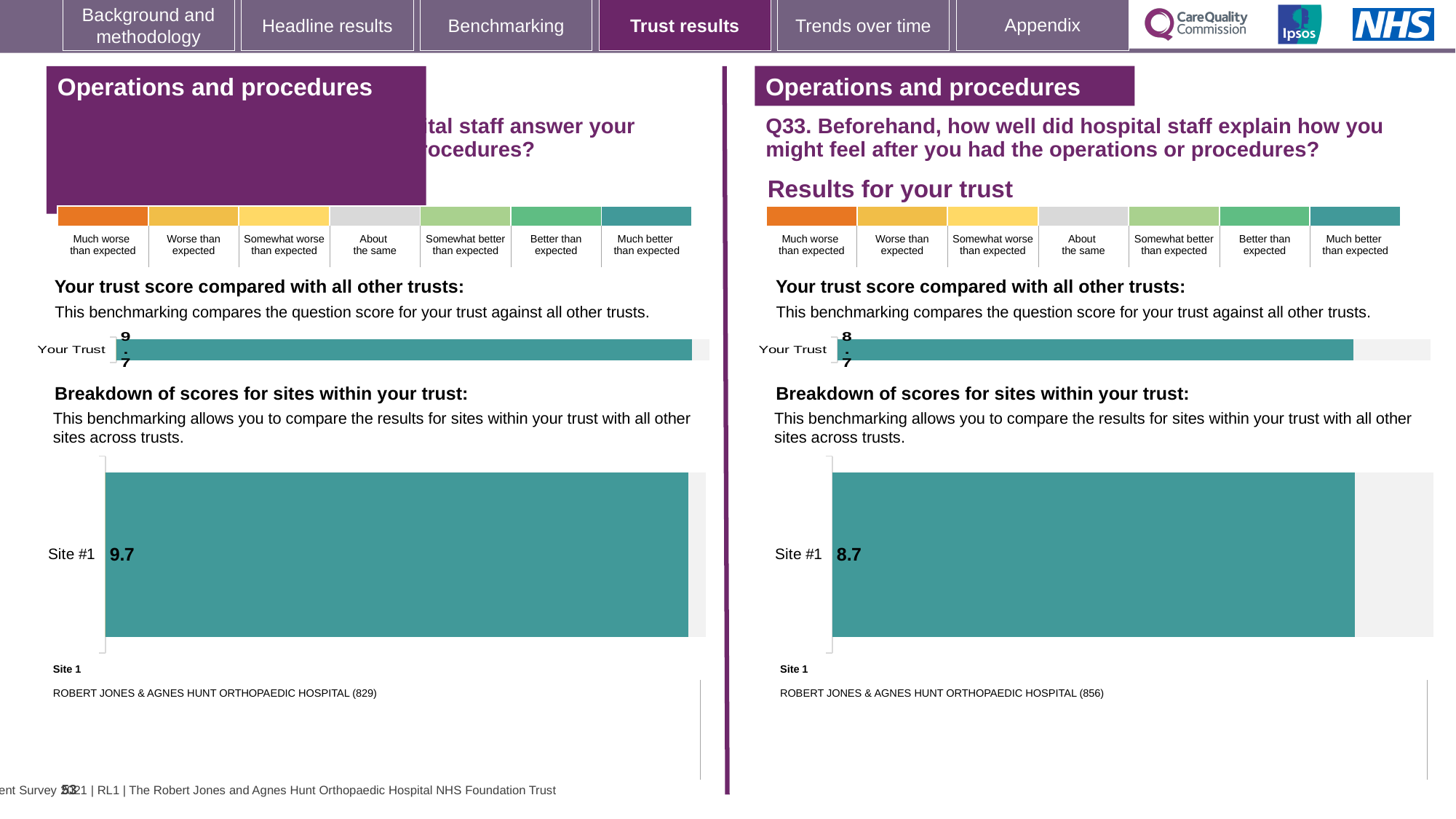
On the left-hand panel, what score is shown for Site #1 in the 'Breakdown of scores for sites within your trust' chart? 9.7 Which is larger: the Site #1 score on the left-hand panel or the Site #1 score on the right-hand panel (Q33)? Left-hand panel (9.7) How many sites are shown in the 'Breakdown of scores for sites within your trust' chart on the right-hand panel (Q33)? 1 How many categories are shown in the colour scale legend above the charts on the right-hand panel (from 'Much worse than expected' to 'Much better than expected')? 7 Is the Your Trust score on the right-hand panel (Q33) the same as the Site #1 score on that panel? Yes, both are 8.7 What type of chart is used to show the Site #1 score on the right-hand panel (Q33)? Bar chart Which site name is listed as Site 1 on the right-hand panel (Q33)? ROBERT JONES & AGNES HUNT ORTHOPAEDIC HOSPITAL (856) On the right-hand panel (Q33), what is the score shown for Your Trust in the 'Your trust score compared with all other trusts' chart? 8.7 What is the difference between the Site #1 score on the left-hand panel (9.7) and the Site #1 score on the right-hand panel (8.7)? 1.0 On the right-hand panel (Q33), what score is shown for Site #1 in the 'Breakdown of scores for sites within your trust' chart? 8.7 How many bars are plotted in the 'Your trust score compared with all other trusts' chart on the left-hand panel? 1 On the left-hand panel, what is the score shown for Your Trust in the 'Your trust score compared with all other trusts' chart? 9.7